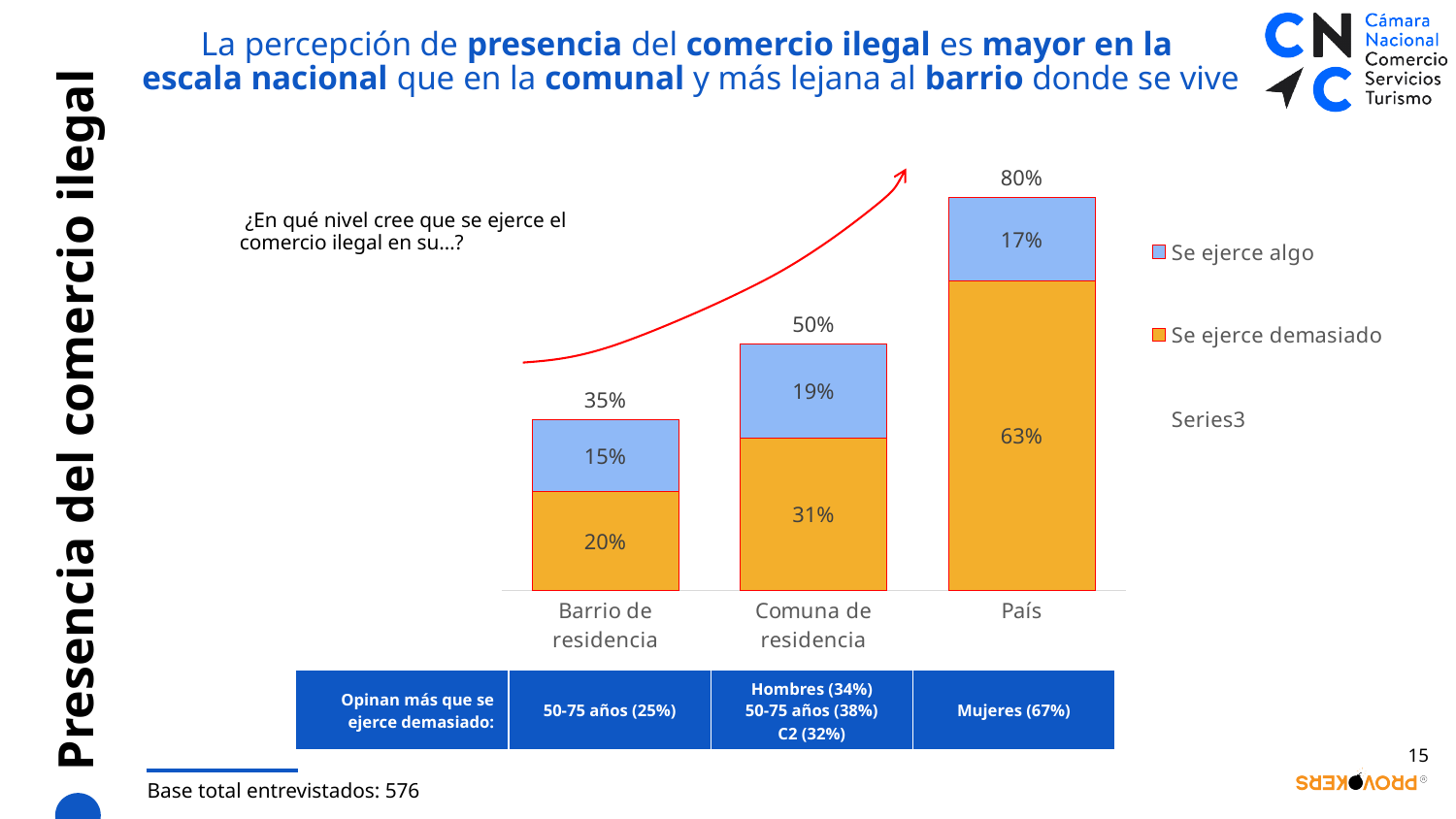
What kind of chart is shown on the slide? stacked bar chart What is the value of "Se ejerce algo" for Comuna de residencia? 19% Which is larger: "Se ejerce algo" for Comuna de residencia or for País? Comuna de residencia How many entries does the legend list? 3 What is the value of "Se ejerce demasiado" for País? 63% What is the total shown above the bar for Comuna de residencia? 50% Do the bar totals rise or fall from Barrio de residencia to País? rise What is the difference between the "Se ejerce demasiado" values for País and Comuna de residencia? 32% What is the value of "Se ejerce demasiado" for Barrio de residencia? 20% Which category has the highest total? País Which category has the lowest value for "Se ejerce demasiado"? Barrio de residencia How many categories are shown on the x axis? 3